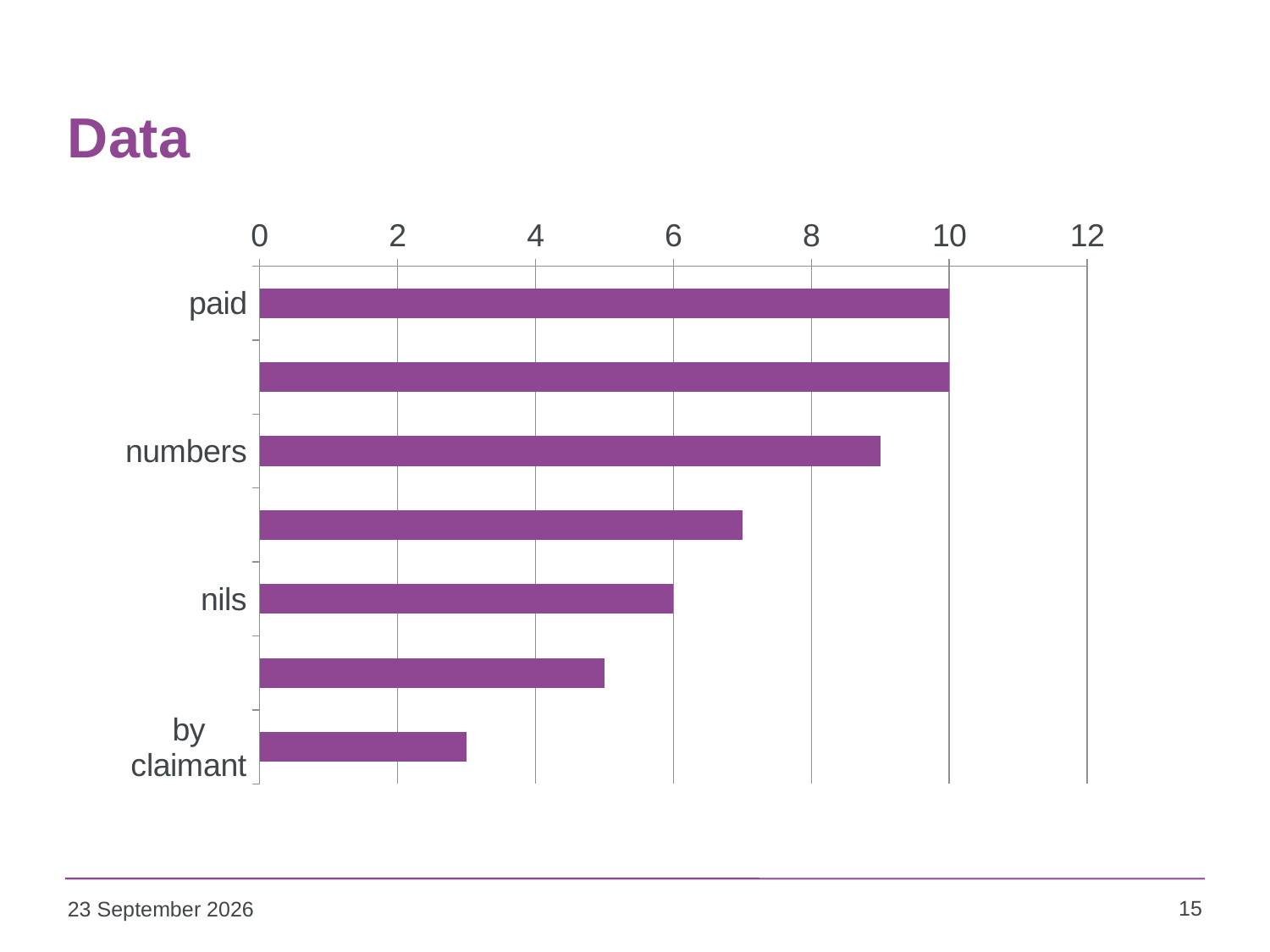
How many bars are plotted in the chart? 7 What type of chart is shown on the slide? bar chart What is the value for "nils"? 6 Which is larger, the value for "paid" or the value for "nils"? paid What is the difference between the values for "paid" and "nils"? 4 Is the value for "by claimant" greater or less than 2? greater What is the value for "paid"? 10 Is the value for "numbers" greater or less than 8? greater Which is larger, the value for "numbers" or the value for "nils"? numbers Is the value for "by claimant" greater or less than 4? less Which labelled category has the lowest value? by claimant What is the title of the slide containing the chart? Data